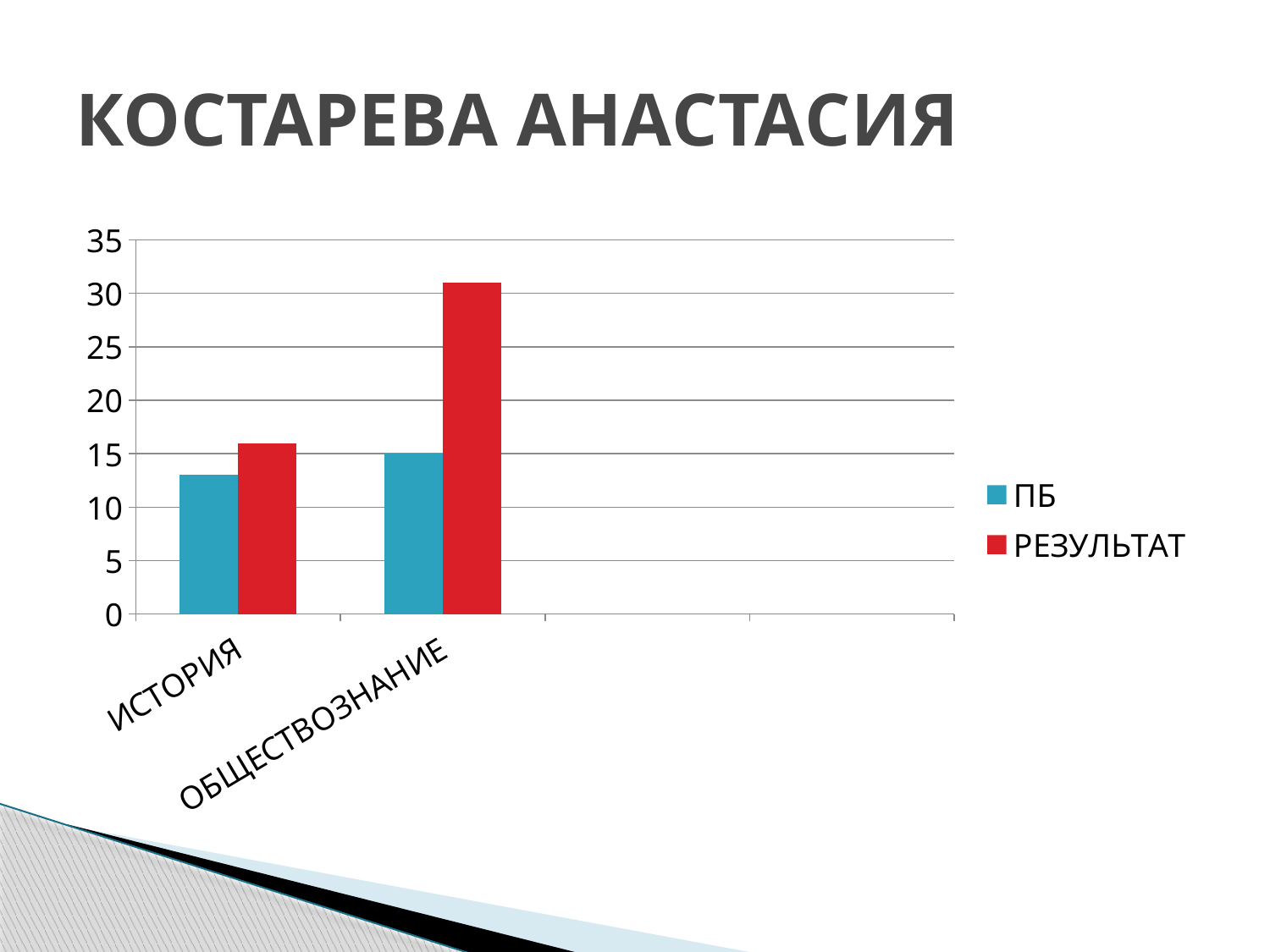
Which category has the lowest ПБ value? ИСТОРИЯ Is the РЕЗУЛЬТАТ value for ИСТОРИЯ greater or less than 20? less Which category has the highest РЕЗУЛЬТАТ value? ОБЩЕСТВОЗНАНИЕ What is the title of the slide? КОСТАРЕВА АНАСТАСИЯ What kind of chart is shown on the slide? bar chart Is the РЕЗУЛЬТАТ value for ОБЩЕСТВОЗНАНИЕ greater or less than 30? greater How many series does the legend list? 2 Which series is shown in red? РЕЗУЛЬТАТ What is the ПБ value for ОБЩЕСТВОЗНАНИЕ? 15 Is the ПБ value for ИСТОРИЯ greater or less than 10? greater For ОБЩЕСТВОЗНАНИЕ, which is larger: ПБ or РЕЗУЛЬТАТ? РЕЗУЛЬТАТ How many categories have bars plotted on the x axis? 2